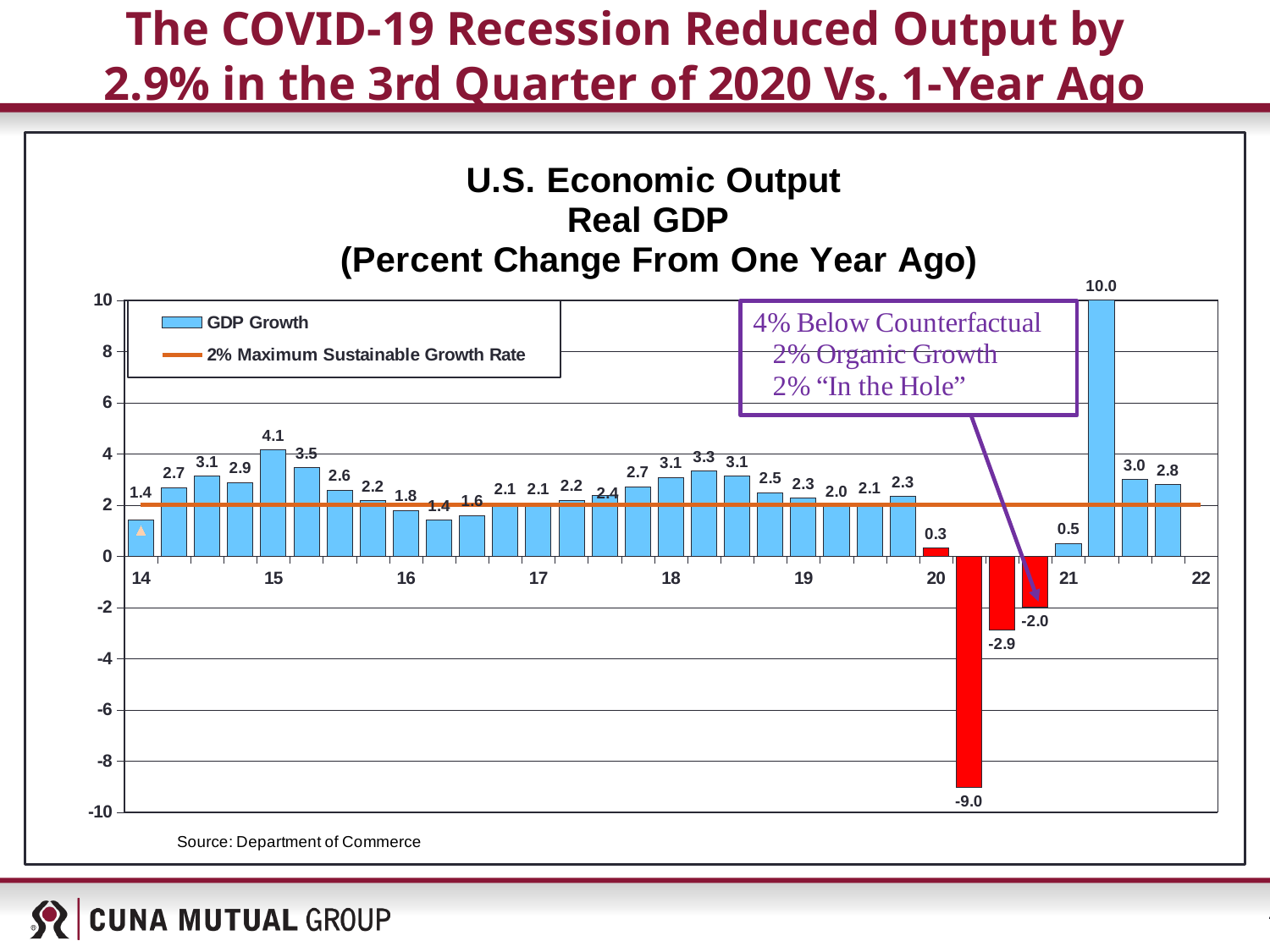
What is the difference between the highest bar (10.0) and the lowest bar (-9.0)? 19.0 What does the orange horizontal line represent according to the legend? 2% Maximum Sustainable Growth Rate What is the value of the bar at the 15 tick on the x axis? 4.1 Which is larger, the first bar on the chart (1.4) or the last bar (2.8)? The last bar (2.8) How many bars are plotted on the chart? 32 What is the highest value shown on the GDP Growth bars? 10.0 What type of chart is shown on the slide? Bar chart What is the value of the last bar on the right side of the chart? 2.8 How many series does the legend list? 2 What is the value of the first bar on the chart, at the 14 tick? 1.4 What source is cited for the chart data? Department of Commerce What is the lowest value shown on the GDP Growth bars? -9.0